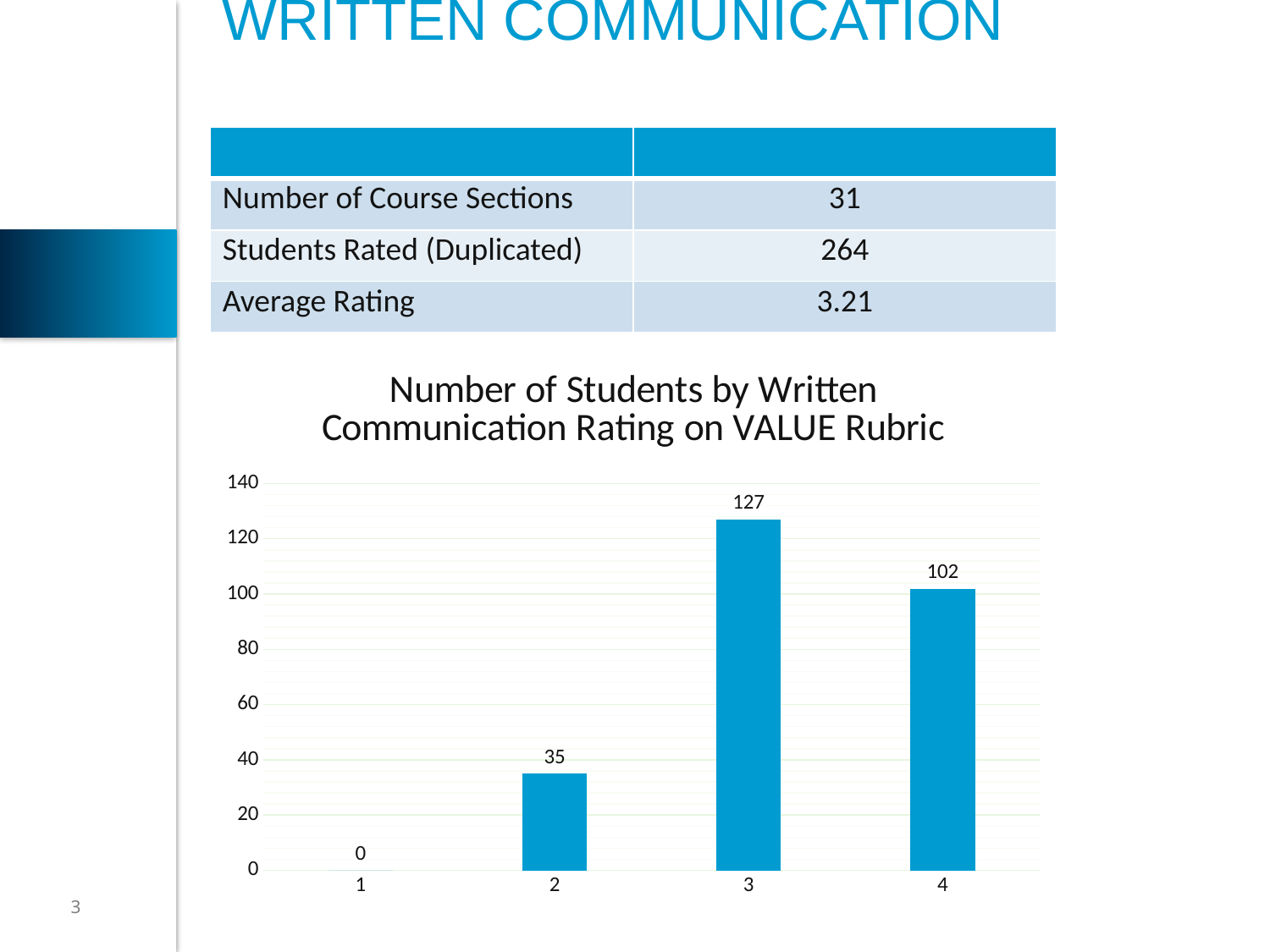
How many students received a rating of 3 on the Written Communication VALUE Rubric? 127 Is the value for rating 3 greater or less than 120? greater What is the difference between the number of students rated 3 and the number rated 4? 25 What type of chart is used to show the number of students by rating? bar chart Which rating has the highest number of students? 3 Which has more students: rating 2 or rating 4? 4 What is the difference between the number of students rated 4 and the number rated 2? 67 Which rating has the lowest number of students? 1 How many rating categories are shown on the x axis of the chart? 4 What is the number of students with a rating of 2? 35 How many students received a rating of 1? 0 How many students received a rating of 4? 102